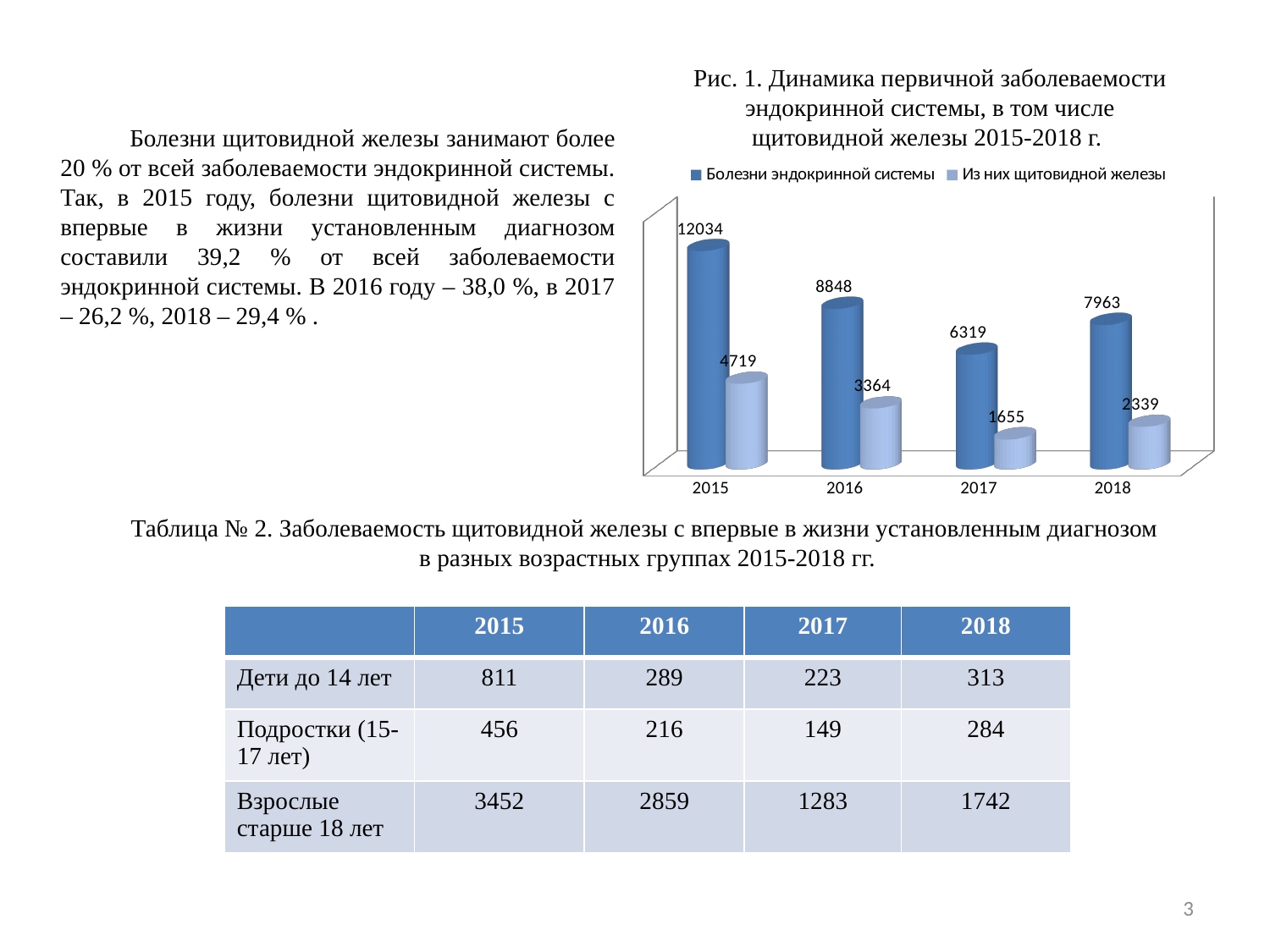
What is the value for 'Болезни эндокринной системы' in 2015? 12034 What is the difference between the 'Болезни эндокринной системы' values for 2015 and 2018? 4071 Which is larger: 'Из них щитовидной железы' in 2016 or in 2018? 2016 Which year has the lowest value for 'Из них щитовидной железы'? 2017 What is the value for 'Из них щитовидной железы' in 2018? 2339 What is the value for 'Из них щитовидной железы' in 2017? 1655 How many years are shown on the x axis of the chart? 4 What kind of chart is shown on the slide? Bar chart What is the difference between 'Болезни эндокринной системы' and 'Из них щитовидной железы' in 2016? 5484 Does the value for 'Болезни эндокринной системы' rise or fall from 2015 to 2017? Fall Which year has the highest value for 'Болезни эндокринной системы'? 2015 How many series does the chart legend list? 2